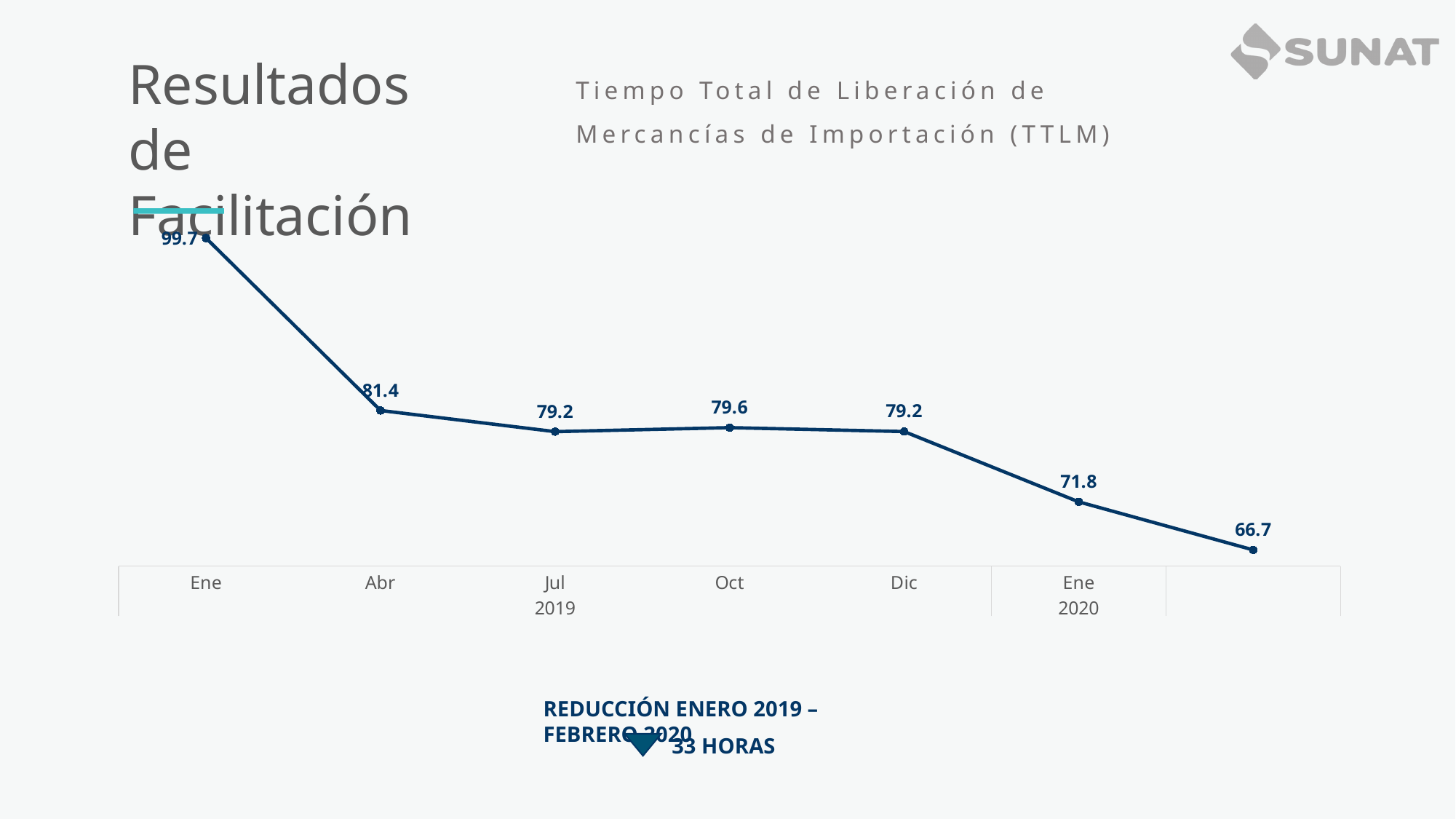
What is the difference between the Ene 2019 value and the Ene 2020 value? 27.9 Do the values generally rise or fall from left to right along the x axis? fall How many data points are plotted on the line? 7 What is the TTLM value for Ene 2020? 71.8 What type of chart is shown on the slide? line chart What is the TTLM value for Oct 2019? 79.6 Which is larger, the value for Oct 2019 or the value for Dic 2019? Oct 2019 What is the value of the last data point on the line? 66.7 What is the TTLM value for Ene 2019? 99.7 What is the difference between the Abr 2019 value and the Jul 2019 value? 2.2 What is the TTLM value for Abr 2019? 81.4 Which labelled month has the highest TTLM value? Ene 2019